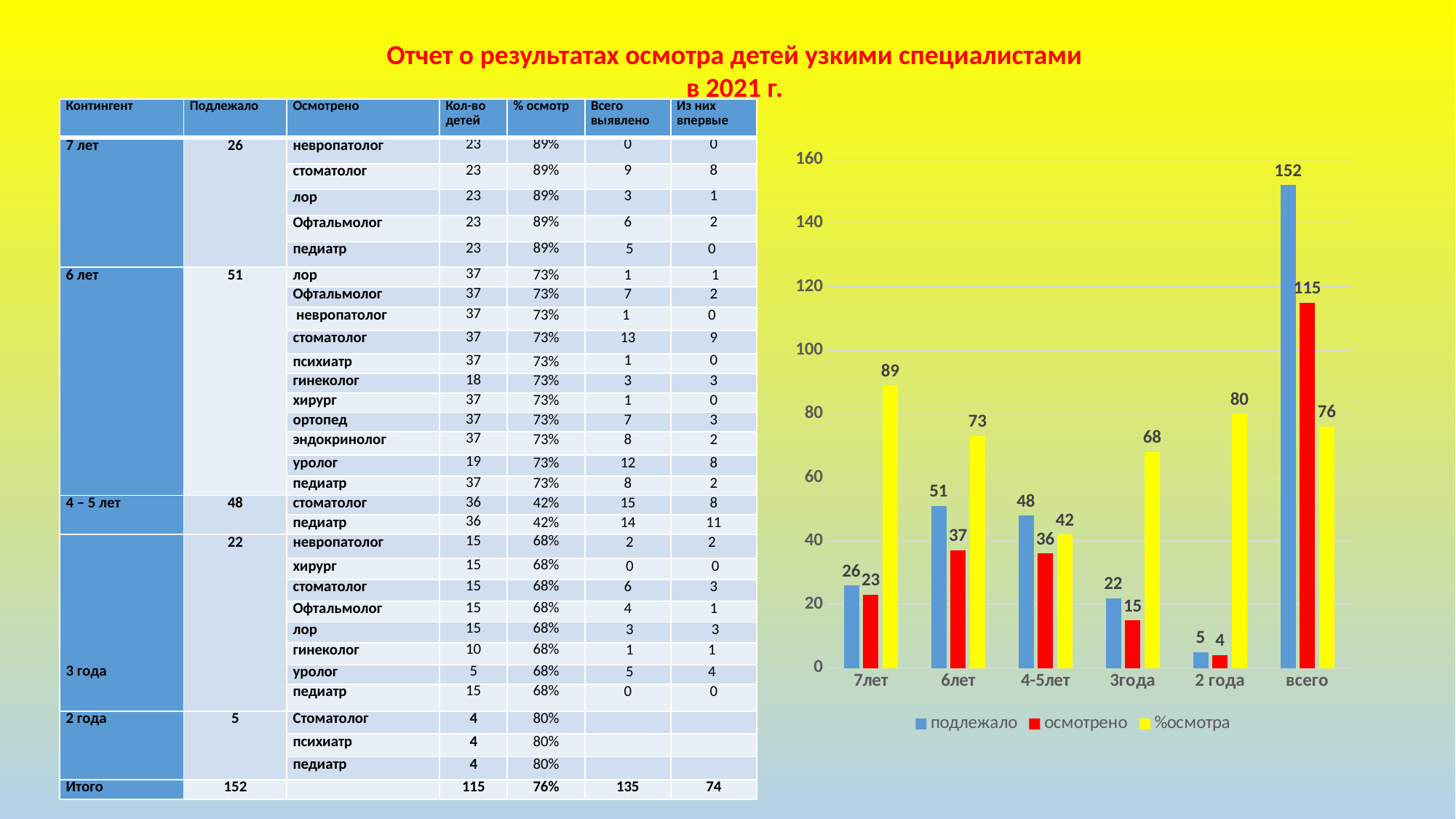
How many categories are shown on the x axis of the chart? 6 What is the value of осмотрено for 3года in the chart? 15 Which category has the lowest подлежало value in the chart? 2 года Which category has the highest %осмотра value in the chart? 7лет Is the value of подлежало for всего greater or less than 140? greater What is the value of %осмотра for 4-5лет in the chart? 42 How many series does the chart legend list? 3 Which is larger in the chart: %осмотра for 2 года or %осмотра for 6лет? 2 года What colour are the осмотрено bars in the chart? red What is the value of подлежало for 6лет in the chart? 51 What is the difference between подлежало and осмотрено for всего in the chart? 37 What type of chart is shown on the slide? bar chart